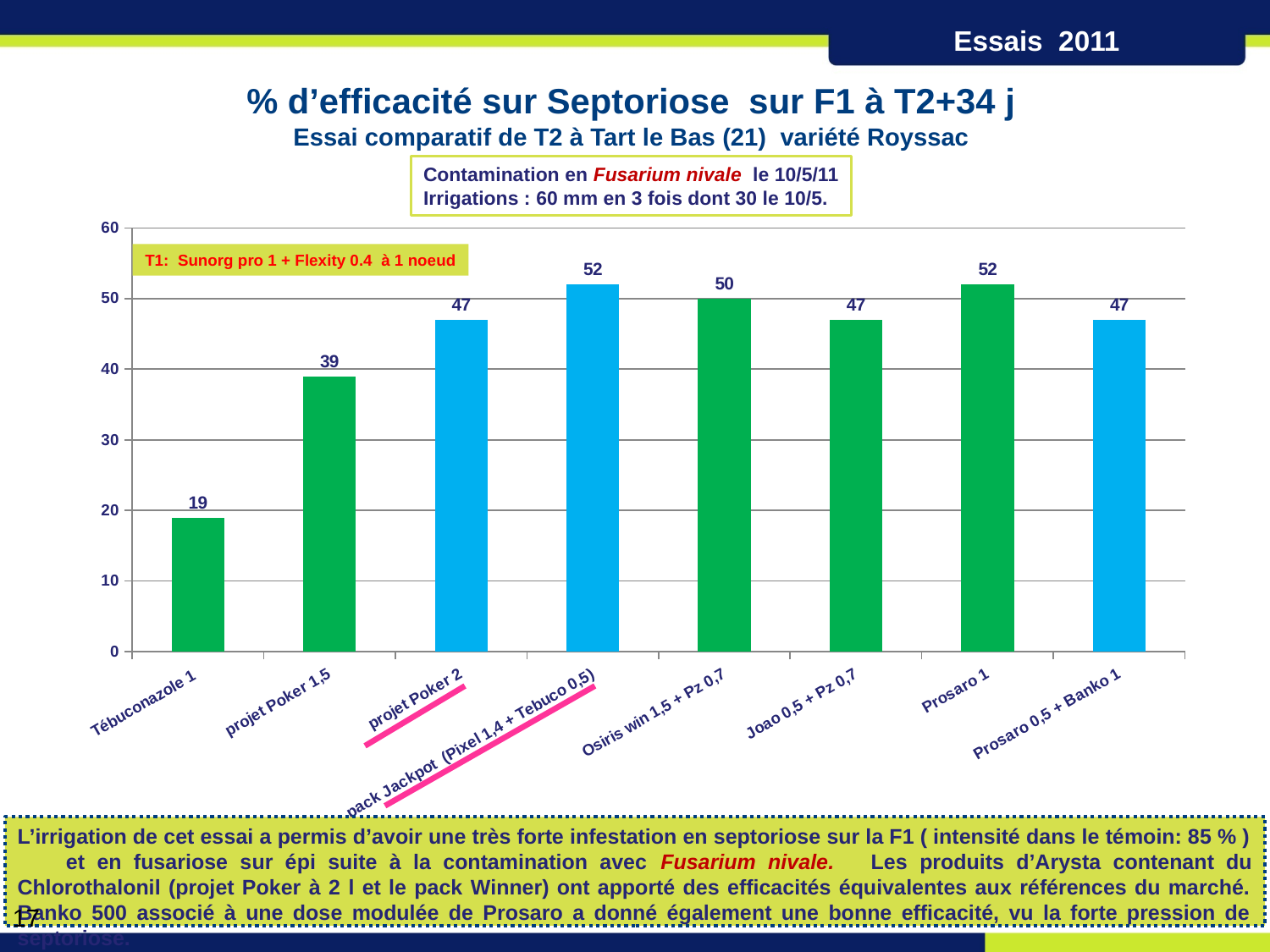
What is the difference between the values for projet Poker 2 and projet Poker 1,5? 8 How many categories are shown on the x axis? 8 What is the value for Prosaro 0,5 + Banko 1? 47 Which category has the lowest value? Tébuconazole 1 What kind of chart is shown on the slide? bar chart Is the value for projet Poker 1,5 greater or less than 40? less What is the value for projet Poker 1,5? 39 What is the title of the chart? % d'efficacité sur Septoriose sur F1 à T2+34 j What is the value for Tébuconazole 1? 19 What is the difference between the values for Prosaro 1 and Tébuconazole 1? 33 Which is larger, the value for Osiris win 1,5 + Pz 0,7 or the value for Joao 0,5 + Pz 0,7? Osiris win 1,5 + Pz 0,7 What is the value for Osiris win 1,5 + Pz 0,7? 50